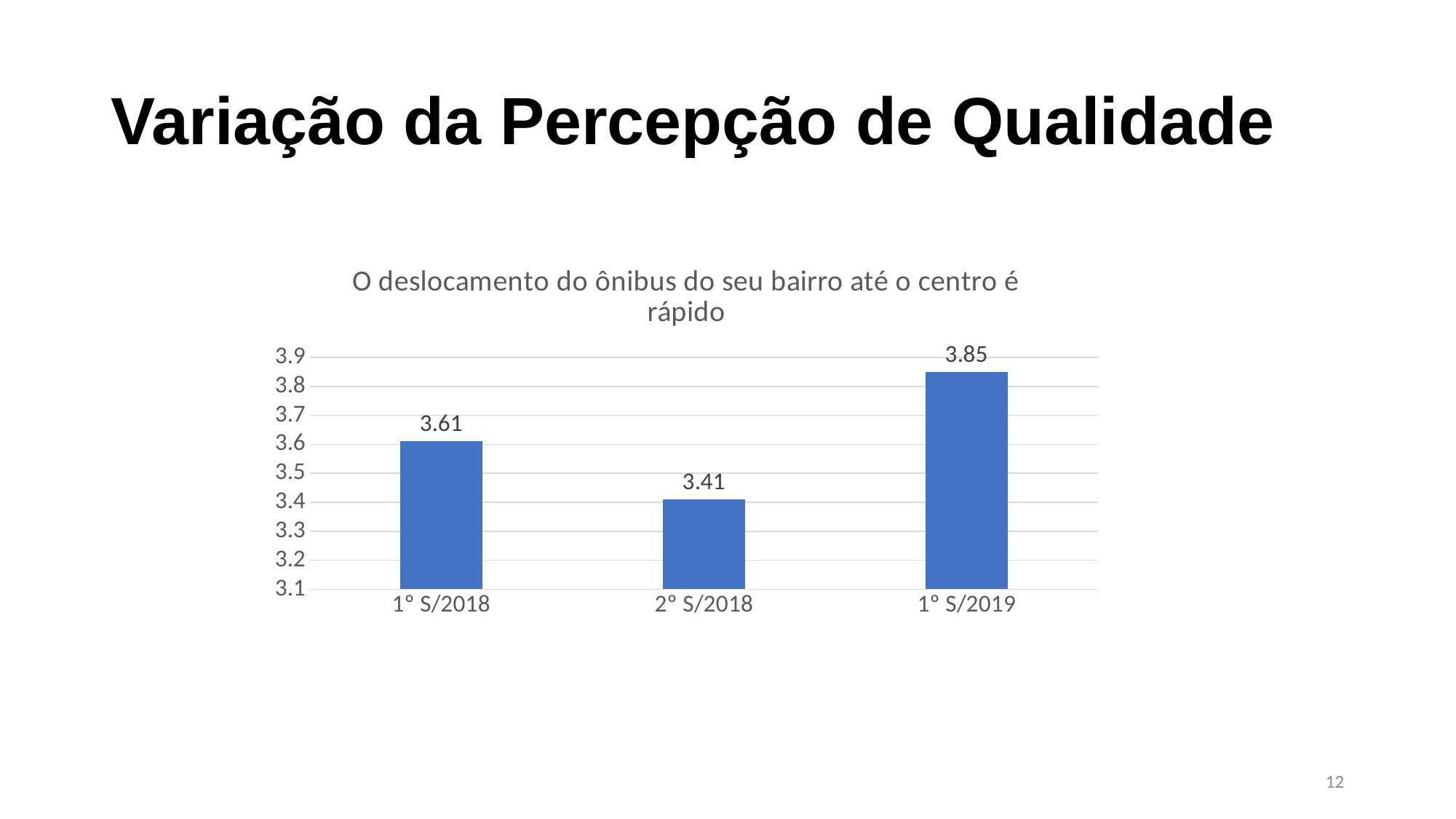
What is the value for 1º S/2019? 3.85 Which category has the highest value? 1º S/2019 Which category has the lowest value? 2º S/2018 What is the title of the chart? O deslocamento do ônibus do seu bairro até o centro é rápido How many categories are shown on the x axis? 3 What is the value for 1º S/2018? 3.61 Is the value for 2º S/2018 greater or less than 3.5? less Which is larger, the value for 1º S/2018 or the value for 1º S/2019? 1º S/2019 What is the value for 2º S/2018? 3.41 What is the difference between the values for 1º S/2019 and 2º S/2018? 0.44 What kind of chart is shown on the slide? bar chart What is the difference between the values for 1º S/2018 and 2º S/2018? 0.2